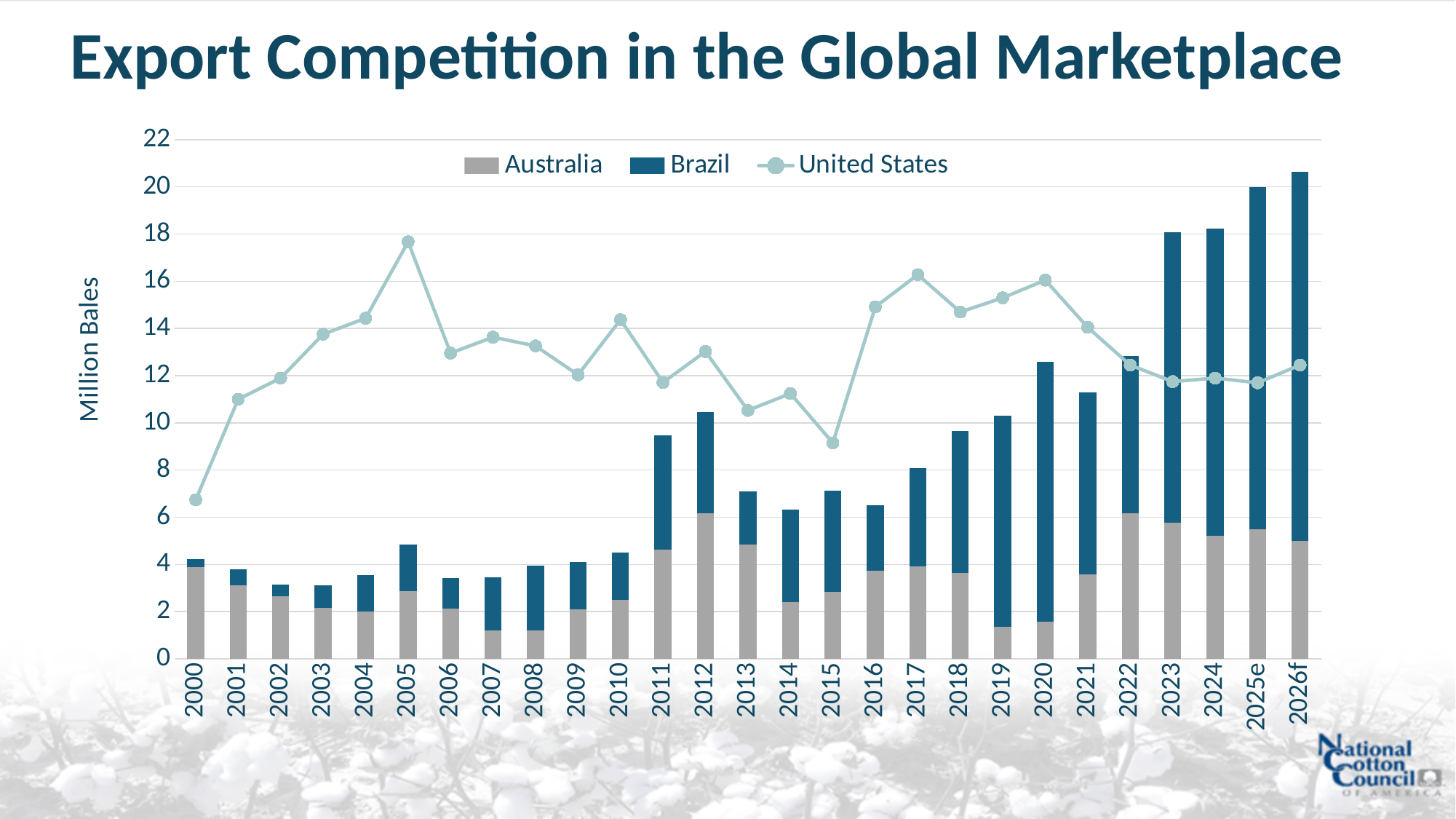
In which year does the United States line reach its highest value? 2005 How many series does the legend list? 3 Is the United States value for 2015 greater or less than 10? less Does the United States line rise or fall from 2000 to 2005? Rise How many years are shown along the x axis? 27 What is the label on the vertical axis? Million Bales What kind of chart is shown on the slide? A stacked bar chart with a line series Which is larger, the United States value in 2005 or in 2015? 2005 In which year is the United States value lowest? 2000 Which series is drawn as a line with markers? United States Is the United States value for 2005 greater or less than 16? greater Which year has the tallest stacked bar (Australia plus Brazil)? 2026f